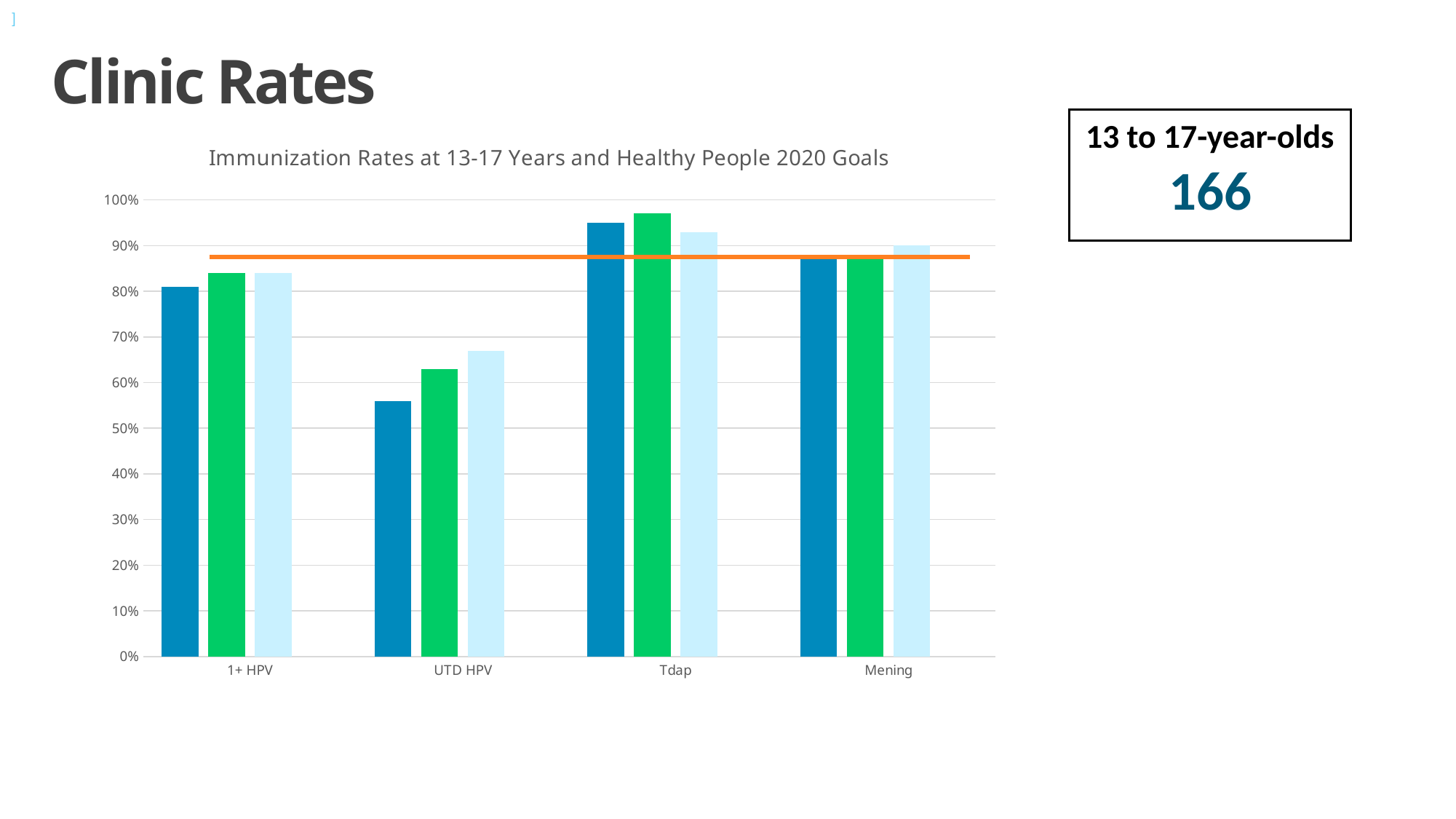
Which category has the highest bars in the chart? Tdap Which category has the larger dark blue bar, Tdap or UTD HPV? Tdap What colour is the horizontal goal line drawn across the chart? orange Is the green bar for Tdap greater or less than 90%? greater What is the title of the chart? Immunization Rates at 13-17 Years and Healthy People 2020 Goals How many bars are plotted for each category in the chart? 3 Is the light blue bar for UTD HPV greater or less than 60%? greater Which category has the lowest bars in the chart? UTD HPV Is the dark blue bar for 1+ HPV greater or less than 70%? greater How many categories are shown on the x axis of the chart? 4 What kind of chart is shown on the slide? bar chart